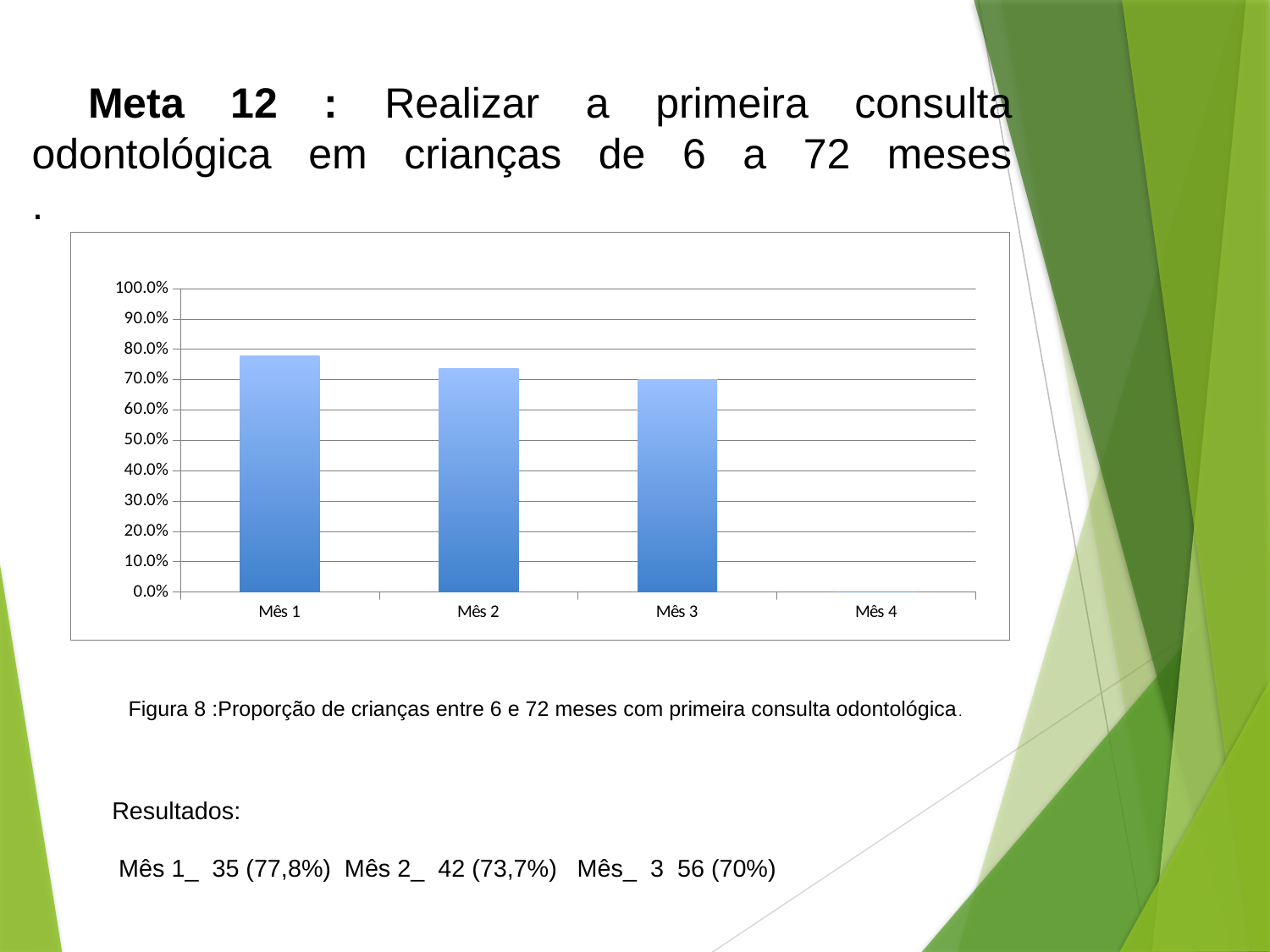
What kind of chart is shown on the slide? bar chart Of the three months with bars plotted, which has the lowest value? Mês 3 Which is larger, the value for Mês 2 or the value for Mês 3? Mês 2 How many month categories are shown on the x axis of the chart? 4 Is the value for Mês 3 greater or less than 60%? greater Do the bar values rise or fall from Mês 1 to Mês 3? fall Is the value for Mês 1 greater or less than 70%? greater According to the results text on the slide, what is the percentage for Mês 3? 70% What is the figure caption given below the chart? Figura 8 :Proporção de crianças entre 6 e 72 meses com primeira consulta odontológica. According to the results text on the slide, what is the percentage for Mês 1? 77,8% Which month has the highest bar in the chart? Mês 1 Is the value for Mês 2 greater or less than 80%? less